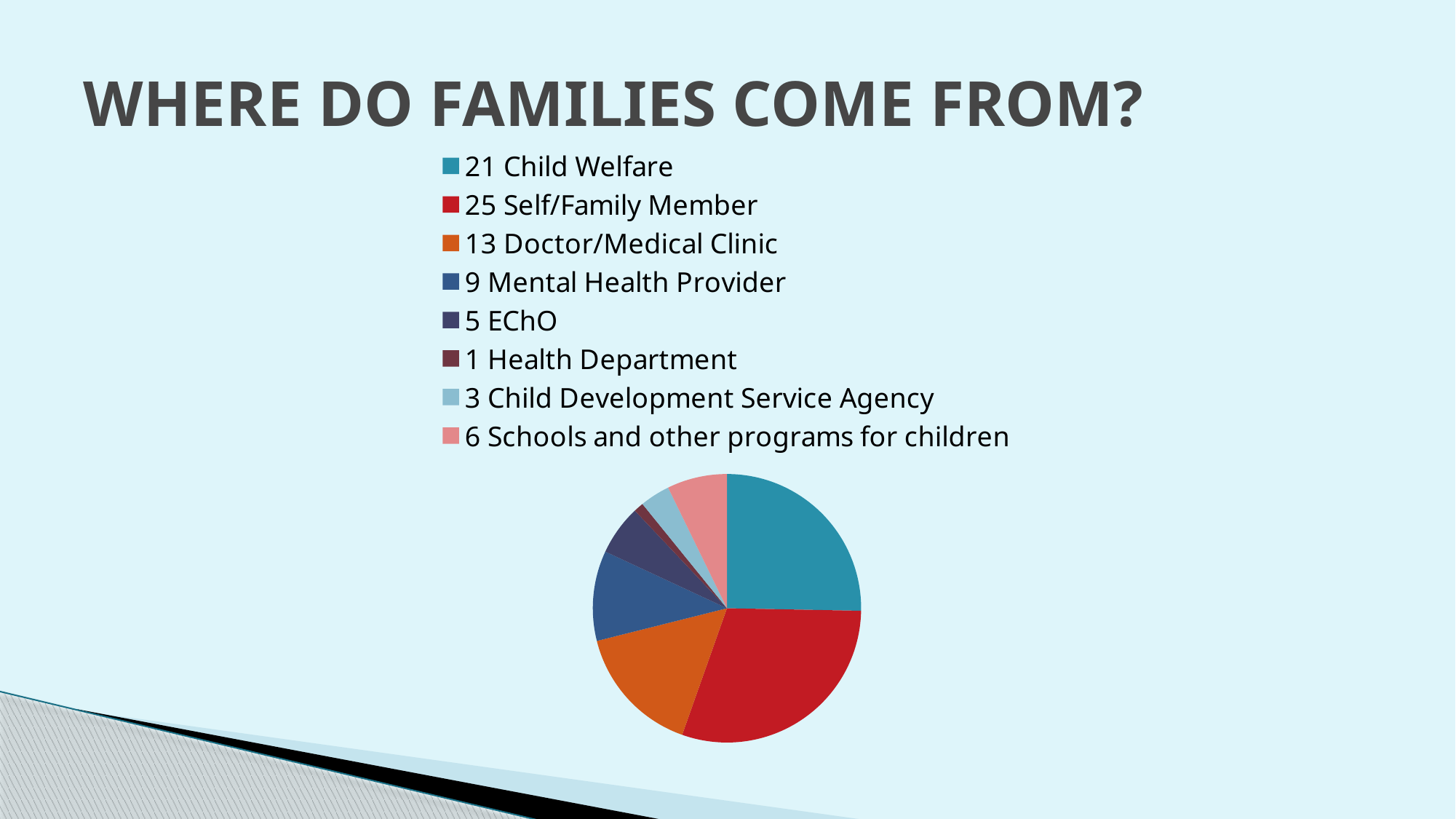
What type of chart is shown on the slide? Pie chart What is the difference between the Self/Family Member and Child Welfare values? 4 What is the value for Doctor/Medical Clinic? 13 What is the value for Self/Family Member? 25 How many categories does the pie chart have? 8 What is the value for EChO? 5 Which is larger, Mental Health Provider or Schools and other programs for children? Mental Health Provider Which category has the largest slice of the pie? Self/Family Member What is the title of the slide containing the pie chart? WHERE DO FAMILIES COME FROM? Which category has the smallest slice of the pie? Health Department How many families came from Child Welfare? 21 What is the total of all the values shown in the legend? 83